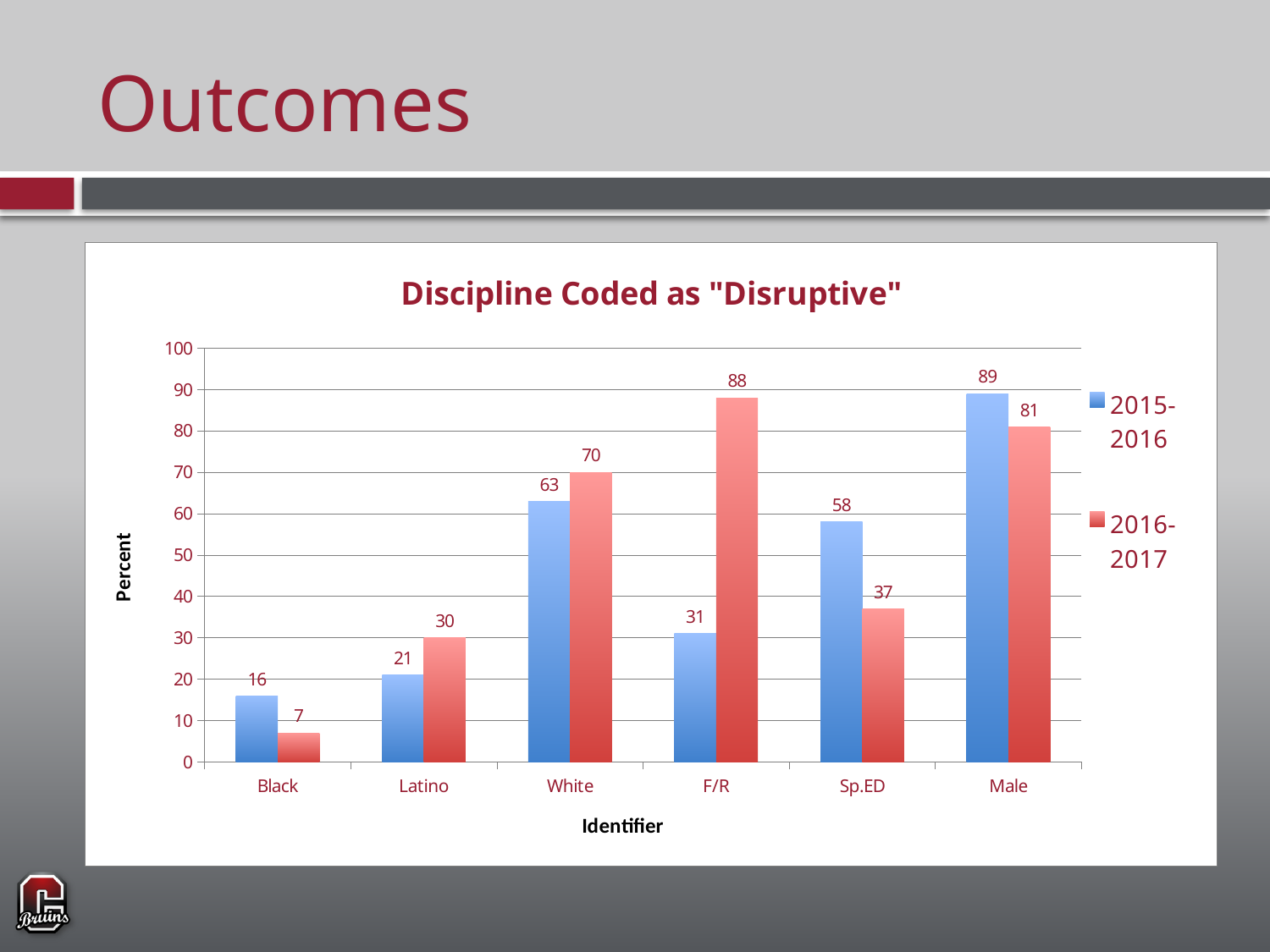
Which identifier has the lowest 2016-2017 value? Black Which identifier has the highest 2015-2016 value? Male What is the 2015-2016 value for White? 63 How many series does the legend list? 2 What is the 2016-2017 value for Black? 7 How many identifiers are shown on the x axis? 6 What is the label of the y axis? Percent What is the difference between the 2016-2017 and 2015-2016 values for F/R? 57 What is the title of the chart? Discipline Coded as "Disruptive" Which is larger for Sp.ED: the 2015-2016 value or the 2016-2017 value? 2015-2016 What kind of chart is shown? Bar chart What is the 2016-2017 value for F/R? 88